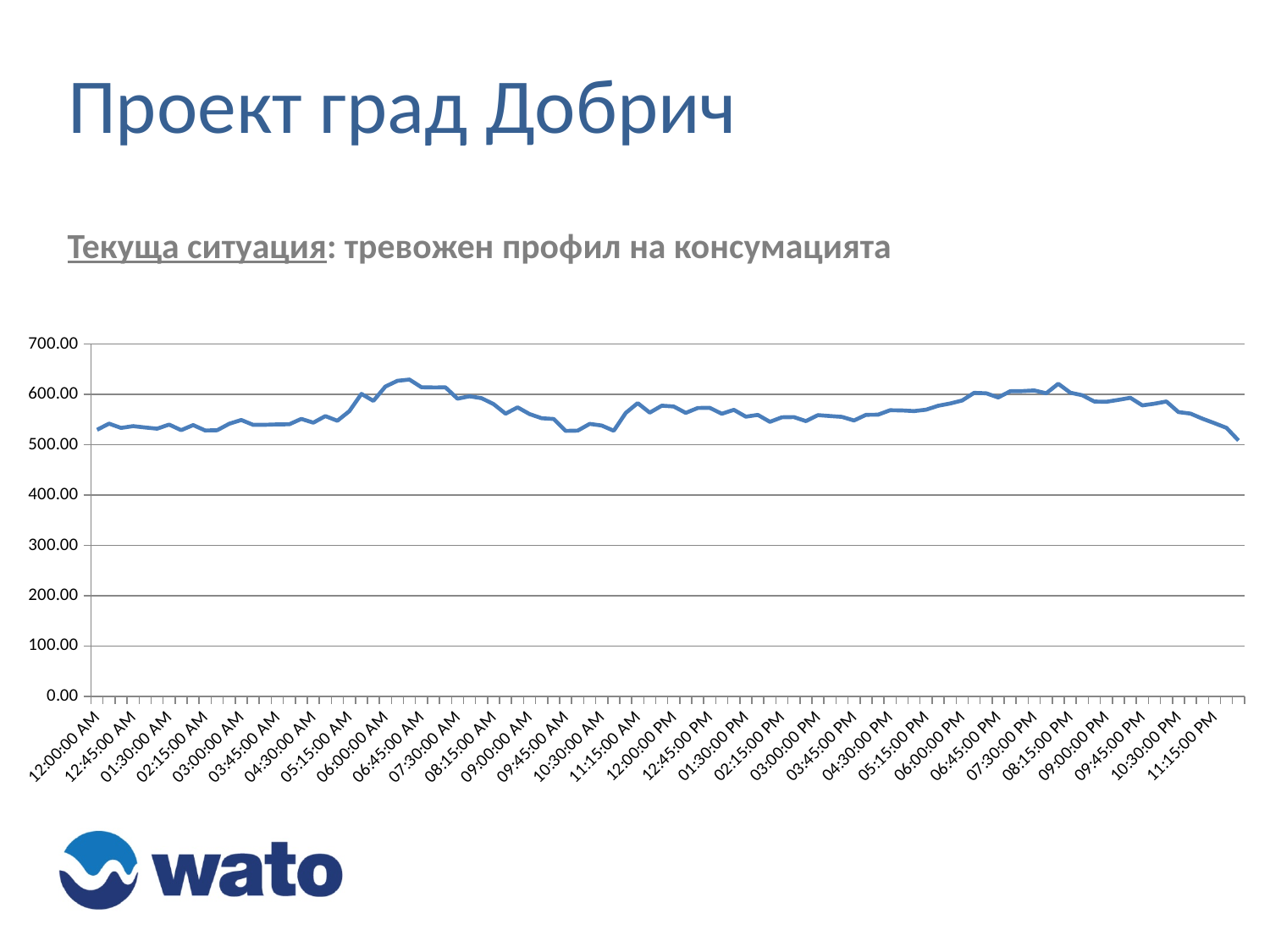
Do the values rise or fall between 05:15:00 AM and 06:45:00 AM? rise What kind of chart is shown on the slide? line chart Is the value at 10:30:00 AM greater or less than 600? less Which is larger, the value at 10:30:00 AM or the value at 08:15:00 PM? 08:15:00 PM Do the values rise or fall from 08:15:00 PM to the end of the series? fall Which is larger, the value at 06:45:00 AM or the value at 12:00:00 AM? 06:45:00 AM Is the value at 06:45:00 AM greater or less than 600? greater Is the value at 03:00:00 PM greater or less than 400? greater What is the highest value shown on the vertical axis? 700.00